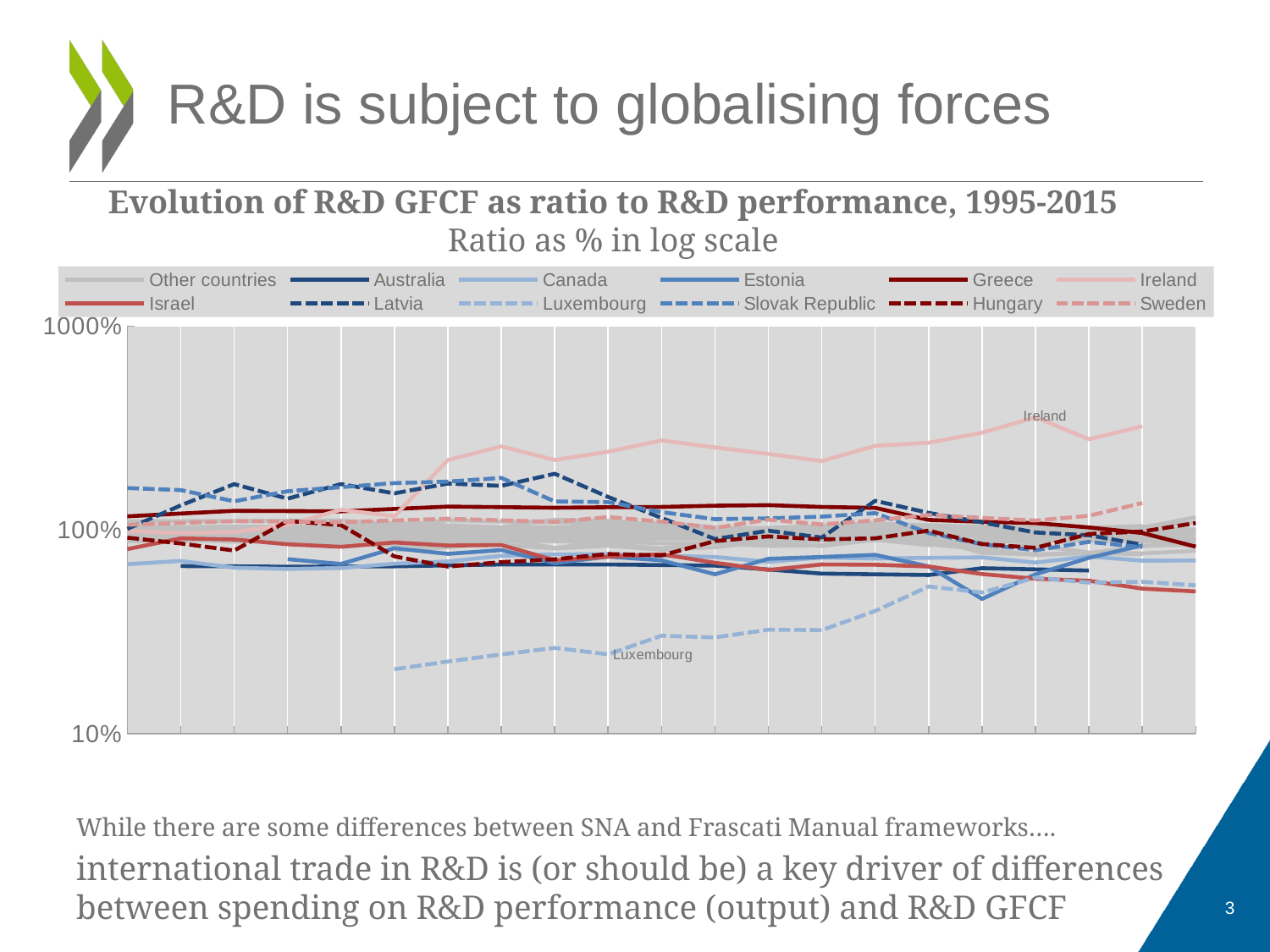
Which country's line is the highest on the chart in the later years? Ireland What does the chart subtitle say about the scale used? Ratio as % in log scale Which two countries are labelled directly on the chart next to their lines? Ireland and Luxembourg How many series does the legend list? 12 Is the value for Luxembourg at its first plotted point greater or less than 100%? less What is the title of the chart? Evolution of R&D GFCF as ratio to R&D performance, 1995-2015 What kind of chart is shown on the slide? Line chart Does the Luxembourg line rise or fall over the period it is plotted? Rise Which country's line is the lowest on the chart? Luxembourg Is the value for Ireland at the end of the period greater or less than 100%? greater Which is larger at the end of the period, the value for Ireland or the value for Luxembourg? Ireland Is the value for Ireland at the end of the period greater or less than 1000%? less